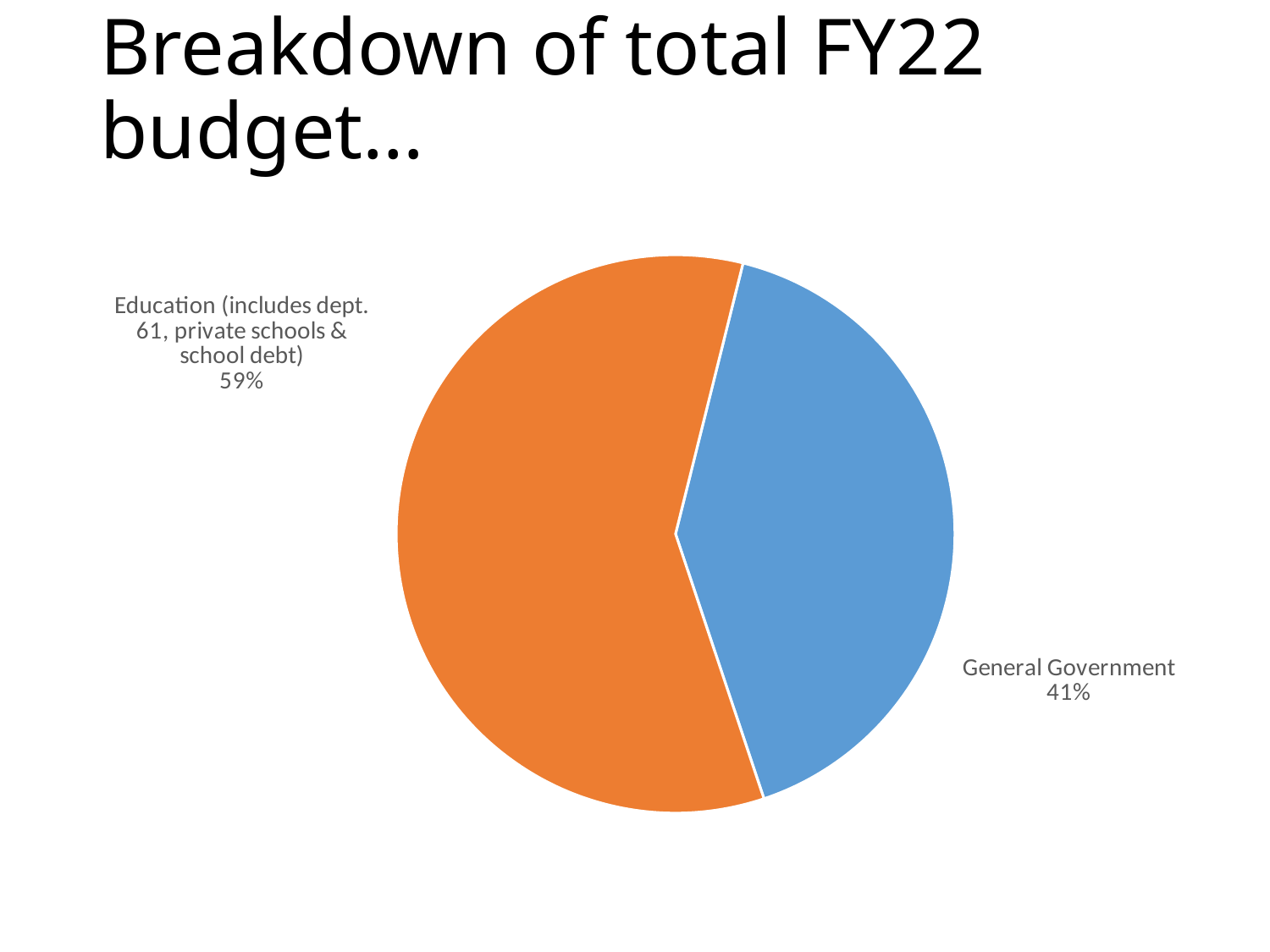
Which is larger, the Education share or the General Government share? Education What is the title of the slide? Breakdown of total FY22 budget… What share of the FY22 budget goes to General Government? 41% How many slices does the pie chart have? 2 What kind of chart is shown on the slide? pie chart By how many percentage points does the Education share exceed the General Government share? 18 What share of the FY22 budget goes to Education (includes dept. 61, private schools & school debt)? 59% Is the General Government share greater or less than 50%? less Which category has the largest share of the FY22 budget? Education (includes dept. 61, private schools & school debt) Which category has the smallest share of the FY22 budget? General Government What colour is the General Government slice? blue